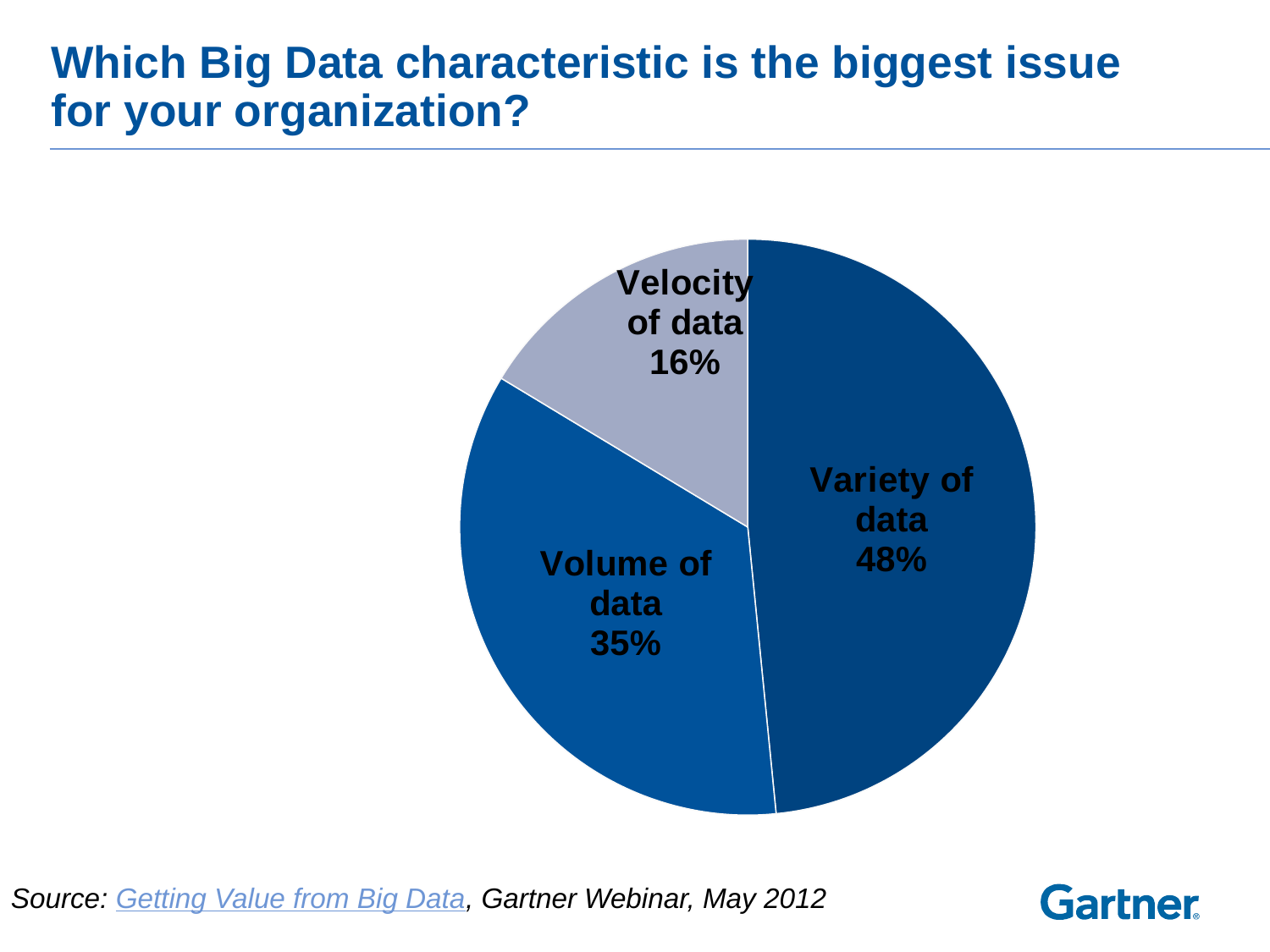
Which has a larger share, Volume of data or Velocity of data? Volume of data Which slice of the pie is shown in the lightest colour? Velocity of data What is the difference in percentage points between Volume of data and Velocity of data? 19 What percentage of respondents chose Velocity of data as the biggest issue? 16% How many slices does the pie chart have? 3 What is the title of the chart on the slide? Which Big Data characteristic is the biggest issue for your organization? What percentage of respondents chose Volume of data as the biggest issue? 35% Which Big Data characteristic has the largest share of the pie? Variety of data What percentage of respondents chose Variety of data as the biggest issue? 48% Which Big Data characteristic has the smallest share of the pie? Velocity of data What is the difference in percentage points between Variety of data and Volume of data? 13 What kind of chart is shown on the slide? Pie chart